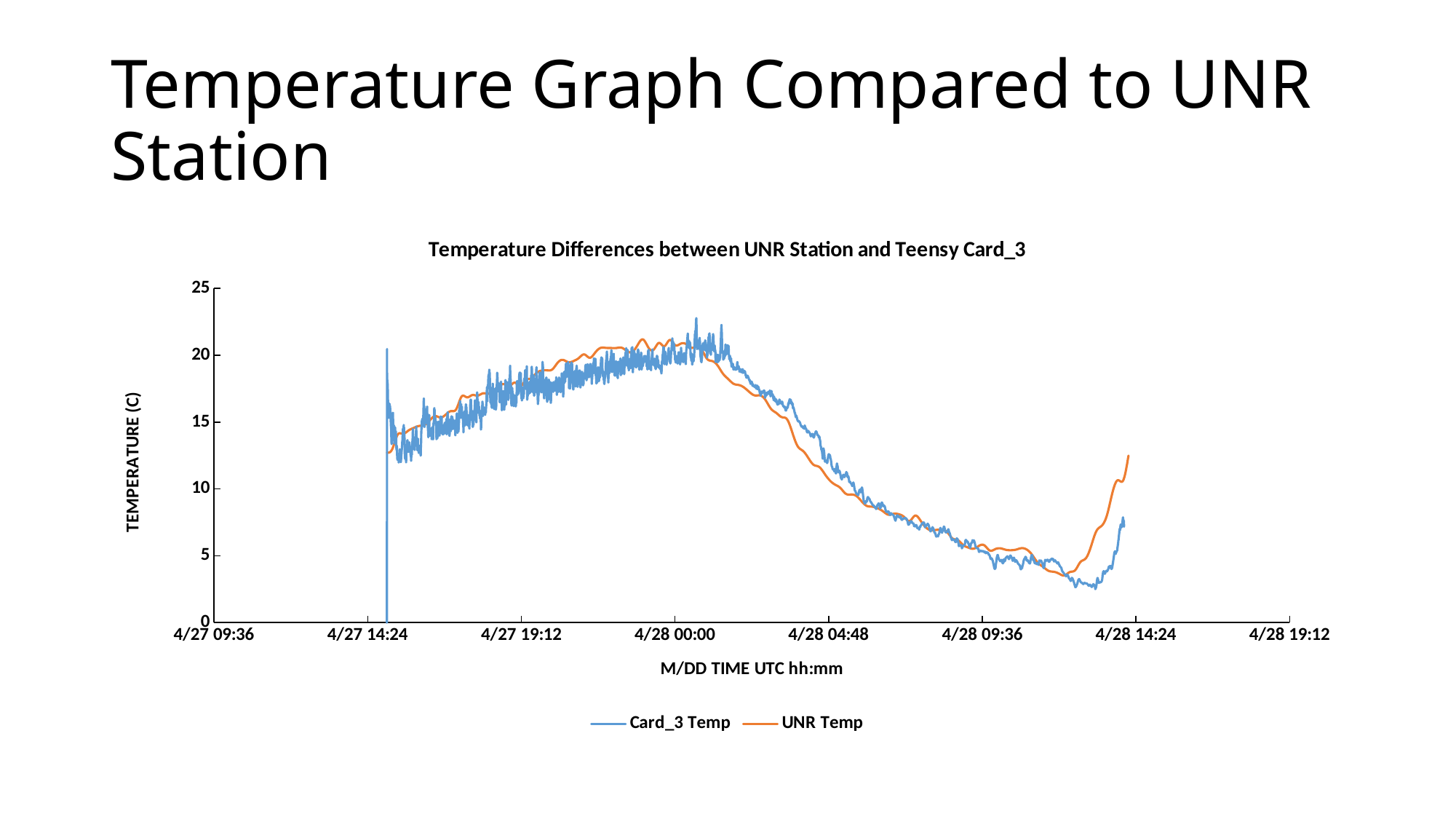
At 4/28 04:48, which series has the higher value, Card_3 Temp or UNR Temp? Card_3 Temp What kind of chart is shown on the slide? line chart Between 4/27 14:24 and 4/28 00:00, does the UNR Temp series generally rise or fall? rise What is the label of the vertical axis? TEMPERATURE (C) Is the value of UNR Temp at 4/28 04:48 greater or less than 15? less Is the value of Card_3 Temp at 4/27 19:12 greater or less than 15? greater Is the value of UNR Temp at 4/27 14:24 greater or less than 15? less Between 4/28 00:00 and 4/28 09:36, do the temperature values rise or fall? fall How many series does the legend list? 2 What is the title of the chart? Temperature Differences between UNR Station and Teensy Card_3 At the right end of the plotted data, near 4/28 14:24, which series has the higher value, Card_3 Temp or UNR Temp? UNR Temp